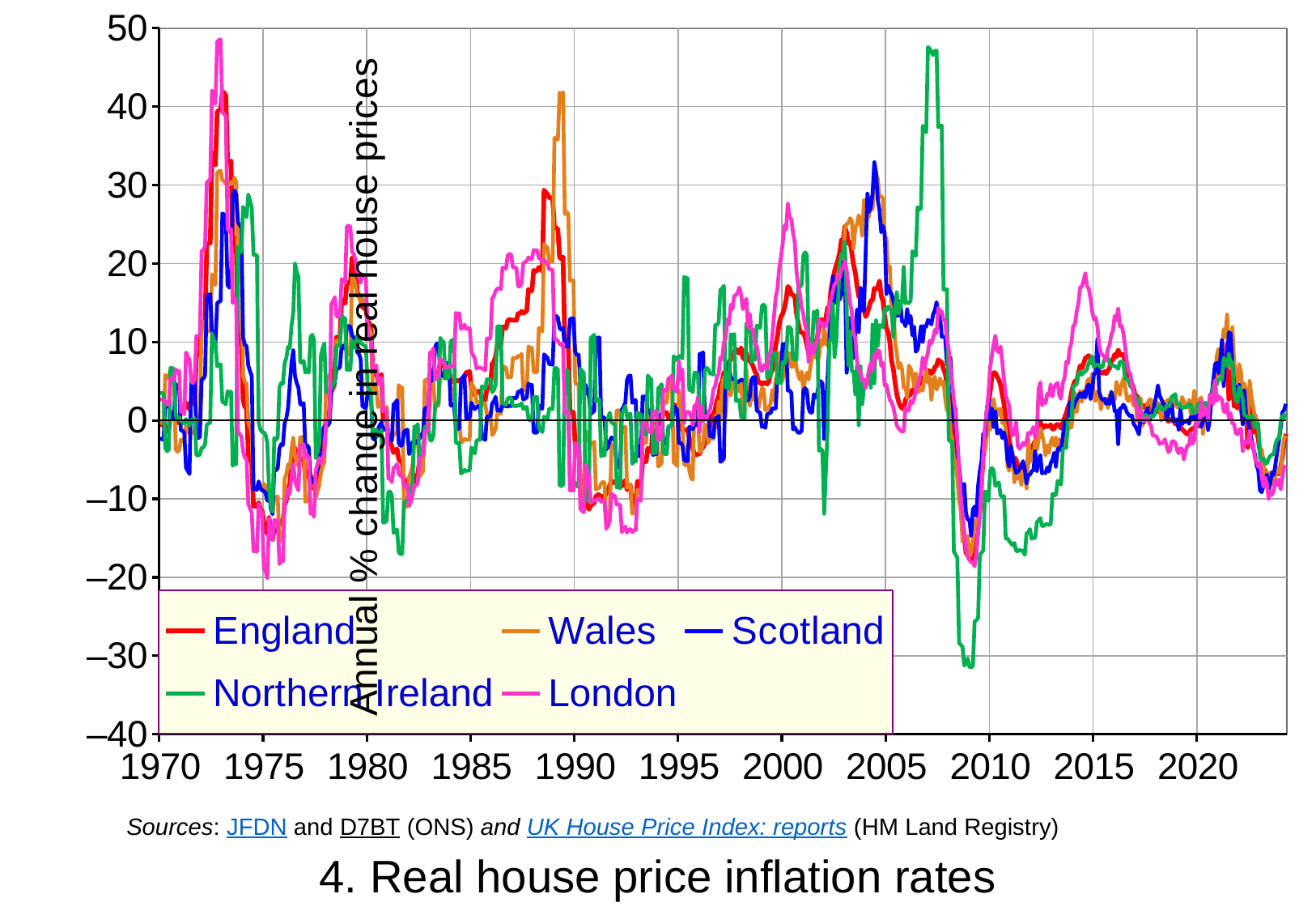
Which series has the highest peak around 2007? Northern Ireland Is the peak value for Scotland around 2004 greater or less than 20? greater Which series is drawn in green? Northern Ireland Around 1989, which series is higher: Wales or Scotland? Wales What is the title of the chart? 4. Real house price inflation rates Is the peak value for Northern Ireland around 2007 greater or less than 40? greater Is the peak value for London around 1973 greater or less than 40? greater How many series does the legend list? 5 Which series reaches the lowest value anywhere on the chart? Northern Ireland What kind of chart is shown on the slide? line chart